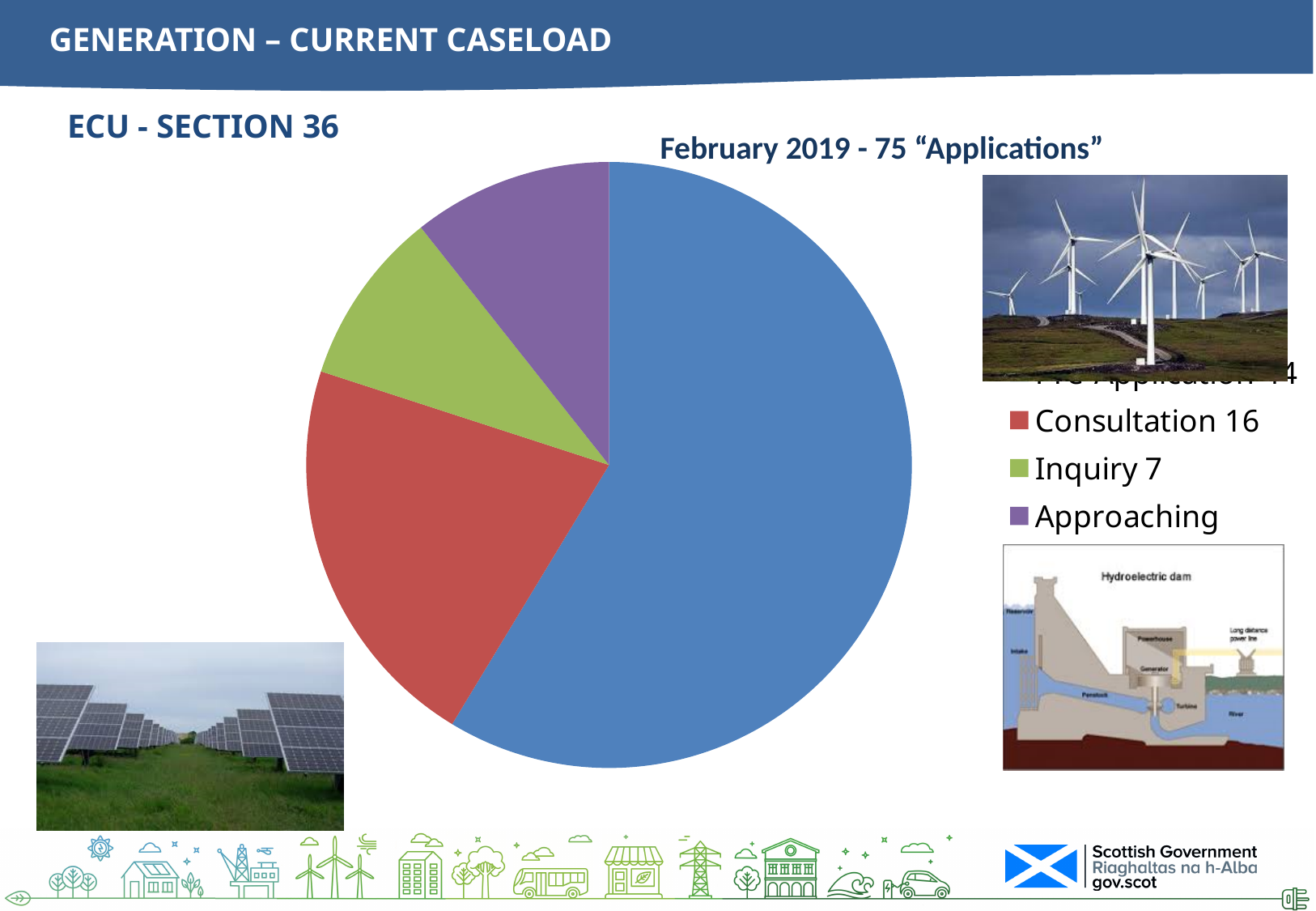
What colour is the Consultation slice? Red What is the title of the pie chart? February 2019 - 75 "Applications" How many slices does the pie chart have? 4 How many applications are in the Consultation category? 16 Which is larger, Consultation or Inquiry? Consultation What kind of chart is shown on the slide? Pie chart Which colour slice is the largest in the pie chart? Blue What is the total number of applications stated in the chart title? 75 How many applications are in the Inquiry category? 7 What is the difference between the Consultation and Inquiry values? 9